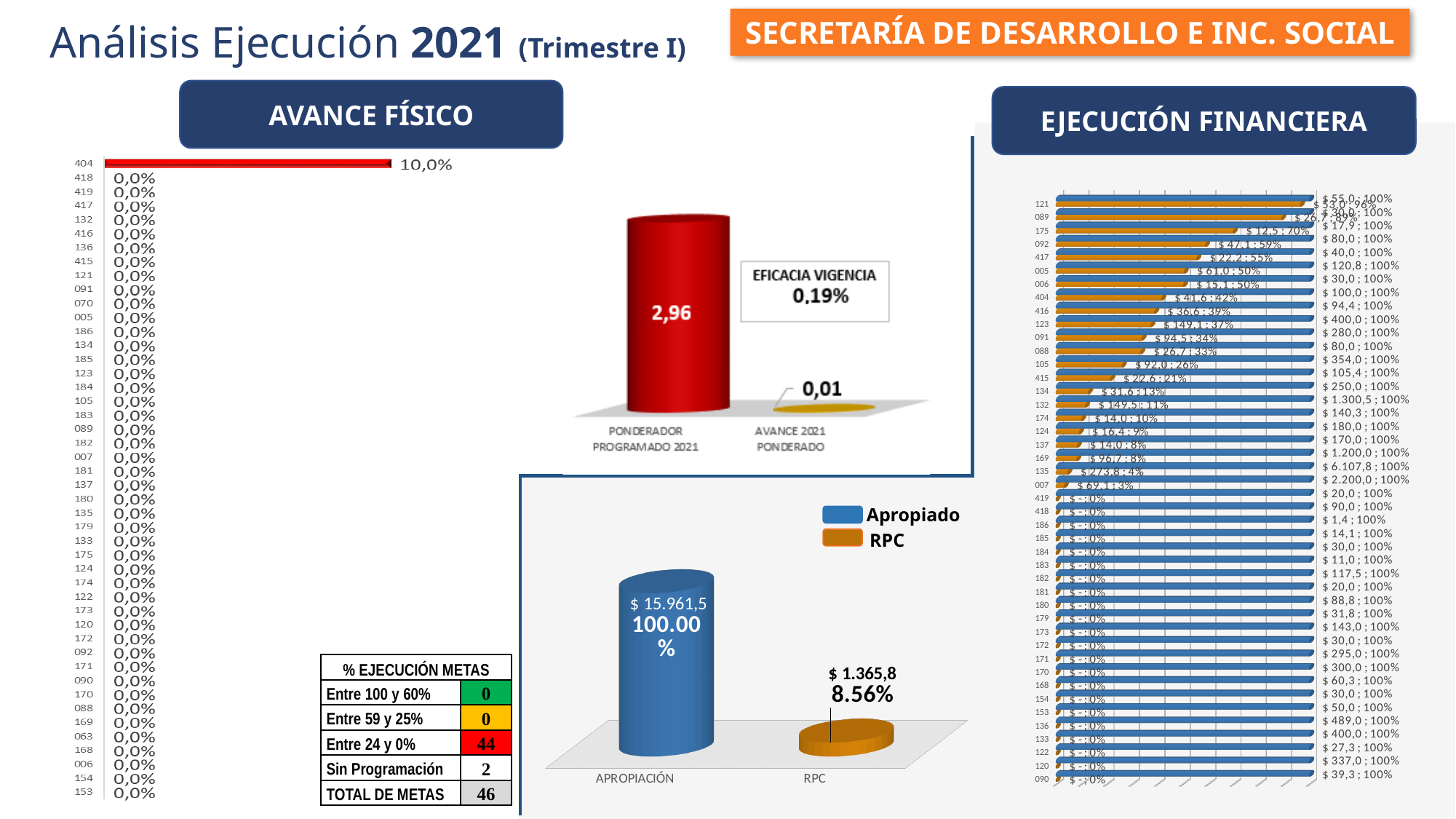
What kind of chart is the EJECUCIÓN FINANCIERA chart on the right? Bar chart In the AVANCE FÍSICO bar chart on the left, what is the value shown for category 404? 10,0% In the chart in the upper middle of the slide, what is the value for AVANCE 2021 PONDERADO? 0,01 How many categories are listed in the AVANCE FÍSICO bar chart on the left? 46 In the chart in the lower middle of the slide, what is the value shown for APROPIACIÓN? $ 15.961,5 In the chart in the upper middle of the slide, what is the value for PONDERADOR PROGRAMADO 2021? 2,96 In the chart in the upper middle of the slide, what is the difference between PONDERADOR PROGRAMADO 2021 and AVANCE 2021 PONDERADO? 2,95 In the AVANCE FÍSICO bar chart on the left, which category has the highest value? 404 In the EJECUCIÓN FINANCIERA chart on the right, what is the Apropiado value labelled for category 132? $ 1.300,5 In the EJECUCIÓN FINANCIERA chart on the right, which category has the highest Apropiado value? 135 In the chart in the lower middle of the slide, what percentage is shown for RPC? 8.56% How many series does the legend of the chart in the lower middle of the slide list? 2